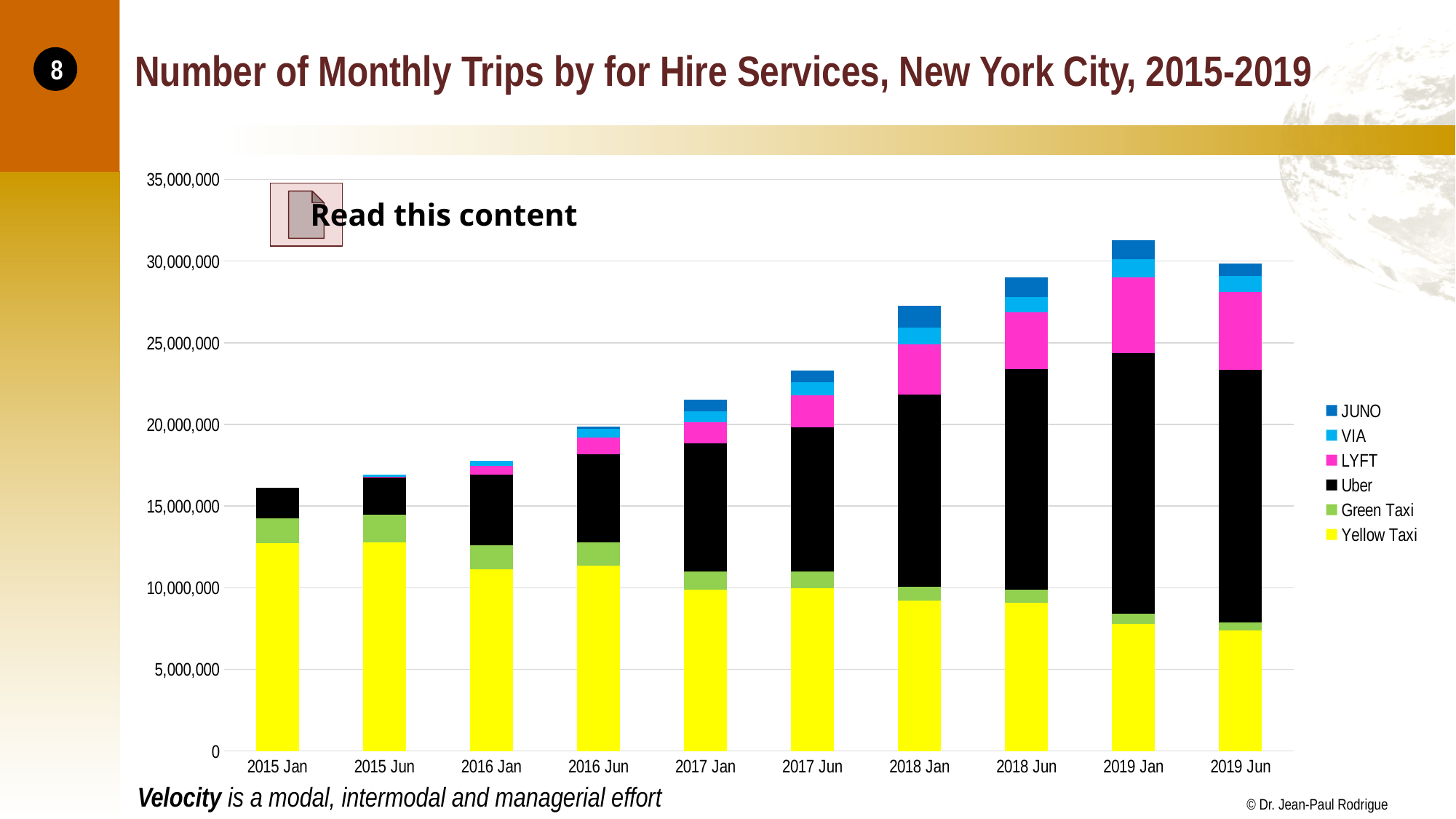
Which period has the larger Uber segment, 2015 Jan or 2019 Jan? 2019 Jan Is the total number of trips for 2015 Jan greater or less than 15,000,000? greater What kind of chart is shown on the slide? Stacked bar chart Which period has the larger Yellow Taxi segment, 2015 Jan or 2019 Jun? 2015 Jan Is the total number of trips for 2017 Jan greater or less than 25,000,000? less How many time periods are shown along the x axis? 10 Which period has the highest total number of monthly trips? 2019 Jan Is the total number of trips for 2019 Jan greater or less than 30,000,000? greater Which colour represents Uber in the legend? Black Do the total monthly trips generally rise or fall from 2015 Jan to 2019 Jan? rise How many series does the legend list? 6 Which period has the lowest total number of monthly trips? 2015 Jan